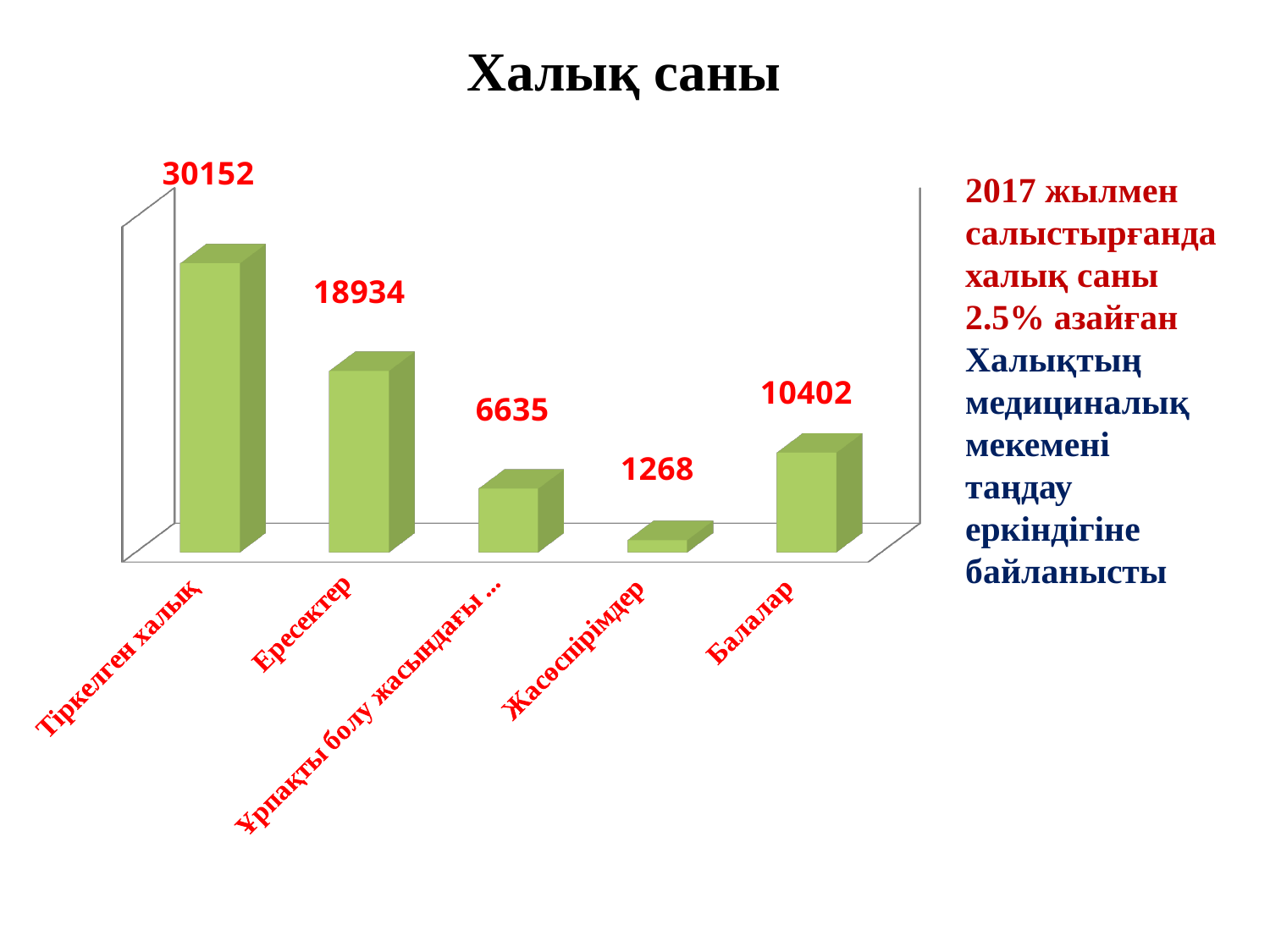
What is the title of the chart? Халық саны Which category has the highest value? Тіркелген халық What is the value for Ересектер? 18934 What is the difference between the values for Тіркелген халық and Ересектер? 11218 What kind of chart is shown on the slide? Bar chart Which is larger, the value for Балалар or the value for Ересектер? Ересектер What is the value for Тіркелген халық? 30152 What is the difference between the values for Балалар and Жасөспірімдер? 9134 What is the value for Жасөспірімдер? 1268 Which category has the lowest value? Жасөспірімдер How many categories are shown in the chart? 5 What is the value for Балалар? 10402